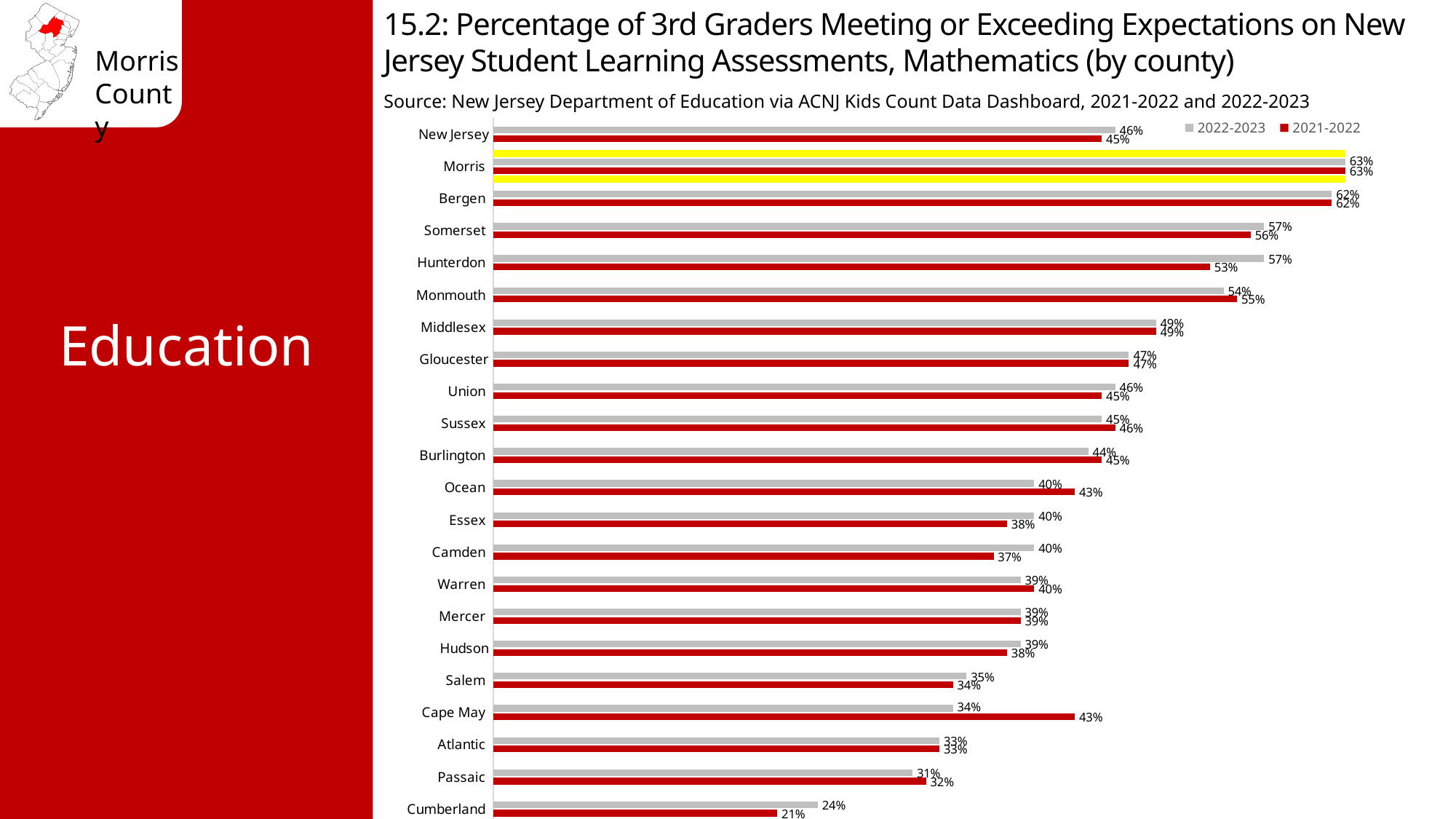
Which county has the highest 2022-2023 value? Morris What kind of chart is shown on the slide? Bar chart What is the difference between the 2022-2023 and 2021-2022 values for Hunterdon? 4% How many series does the legend list? 2 What is the difference between the 2021-2022 and 2022-2023 values for Cape May? 9% What is the 2022-2023 value for Morris? 63% Which category has the lowest 2021-2022 value? Cumberland What is the 2022-2023 value for Hunterdon? 57% What is the 2021-2022 value for Cape May? 43% Which is larger for Ocean: the 2022-2023 value or the 2021-2022 value? 2021-2022 What is the 2021-2022 value for Cumberland? 21% How many categories are shown on the chart? 22